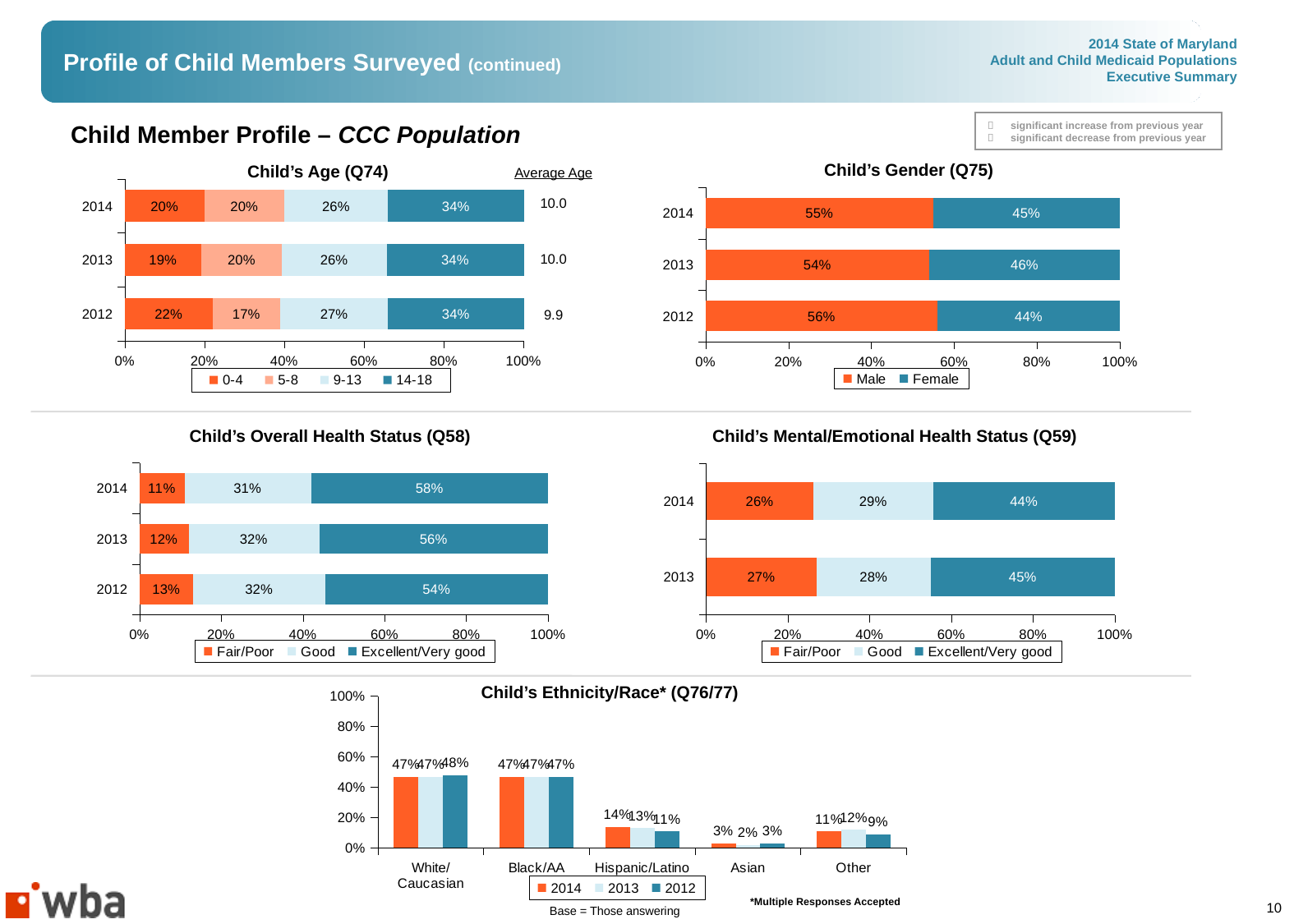
In the Child's Ethnicity/Race (Q76/77) chart, which category has the lowest value for 2013? Asian In the Child's Overall Health Status (Q58) chart, which year has the larger Excellent/Very good percentage, 2014 or 2013? 2014 In the Child's Ethnicity/Race (Q76/77) chart, what percentage of child members were Hispanic/Latino in 2014? 14% In the Child's Overall Health Status (Q58) chart, what percentage was rated Excellent/Very good in 2012? 54% How many years are shown in the Child's Mental/Emotional Health Status (Q59) chart? 2 In the Child's Gender (Q75) chart, what is the difference between the male and female percentages in 2012? 12 percentage points In the Child's Age (Q74) chart, what percentage of child members were aged 14-18 in 2014? 34% In the Child's Age (Q74) chart, what is the average age shown for 2012? 9.9 What kind of chart is the Child's Ethnicity/Race (Q76/77) chart? Bar chart How many series does the legend of the Child's Age (Q74) chart list? 4 In the Child's Mental/Emotional Health Status (Q59) chart, what percentage was rated Fair/Poor in 2014? 26% In the Child's Gender (Q75) chart, what percentage of child members were male in 2013? 54%